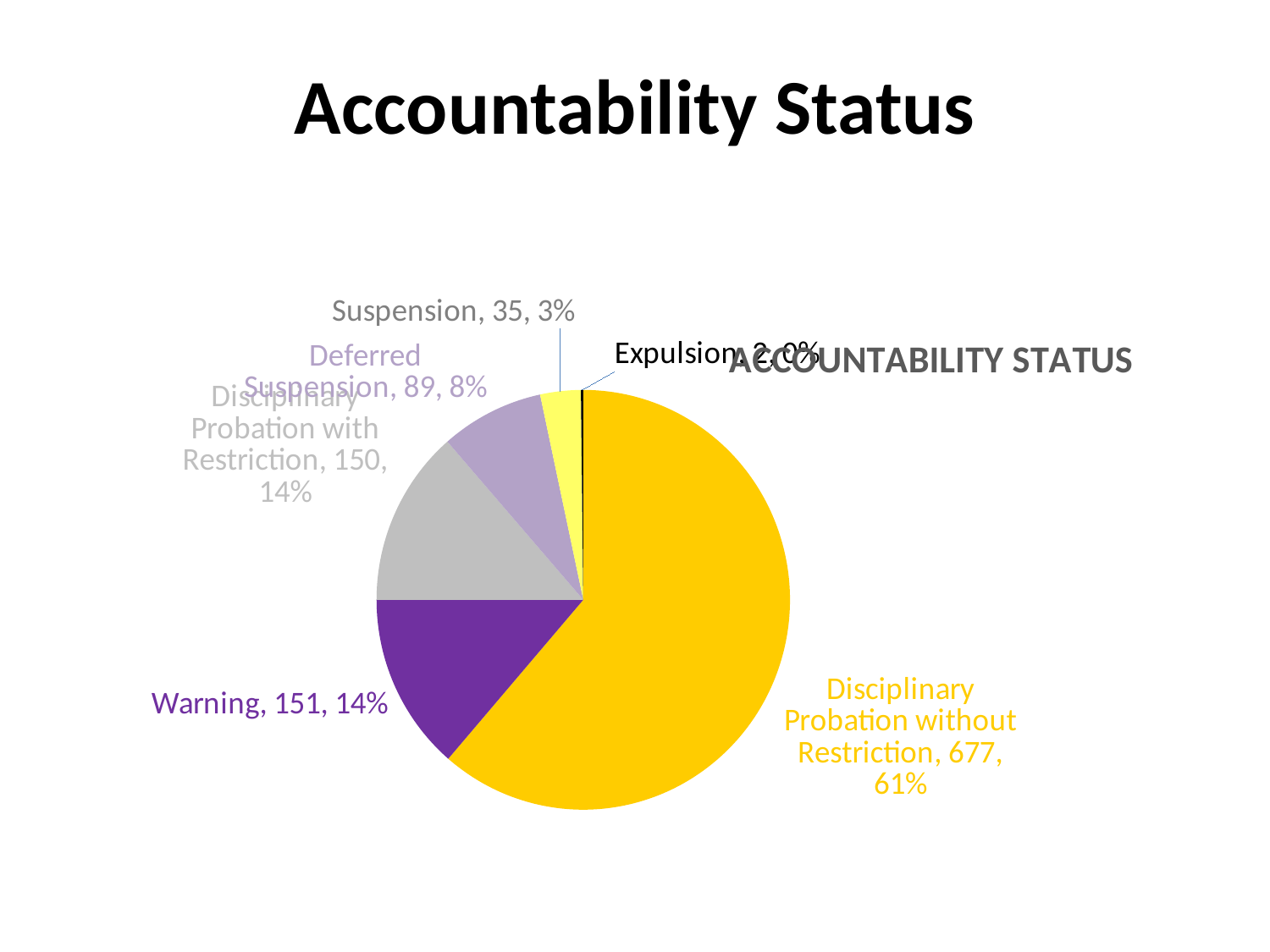
How many slices does the pie chart have? 6 What is the value for Deferred Suspension? 89 Which category has the largest slice? Disciplinary Probation without Restriction What is the value for Warning? 151 What is the difference between the values for Disciplinary Probation without Restriction and Warning? 526 What is the value for Disciplinary Probation without Restriction? 677 Which category has the smallest slice? Expulsion What share of the pie does Disciplinary Probation with Restriction represent? 14% Which is larger, the value for Deferred Suspension or the value for Suspension? Deferred Suspension What kind of chart is shown on the slide? pie chart What share of the pie does Disciplinary Probation without Restriction represent? 61% What is the value for Suspension? 35